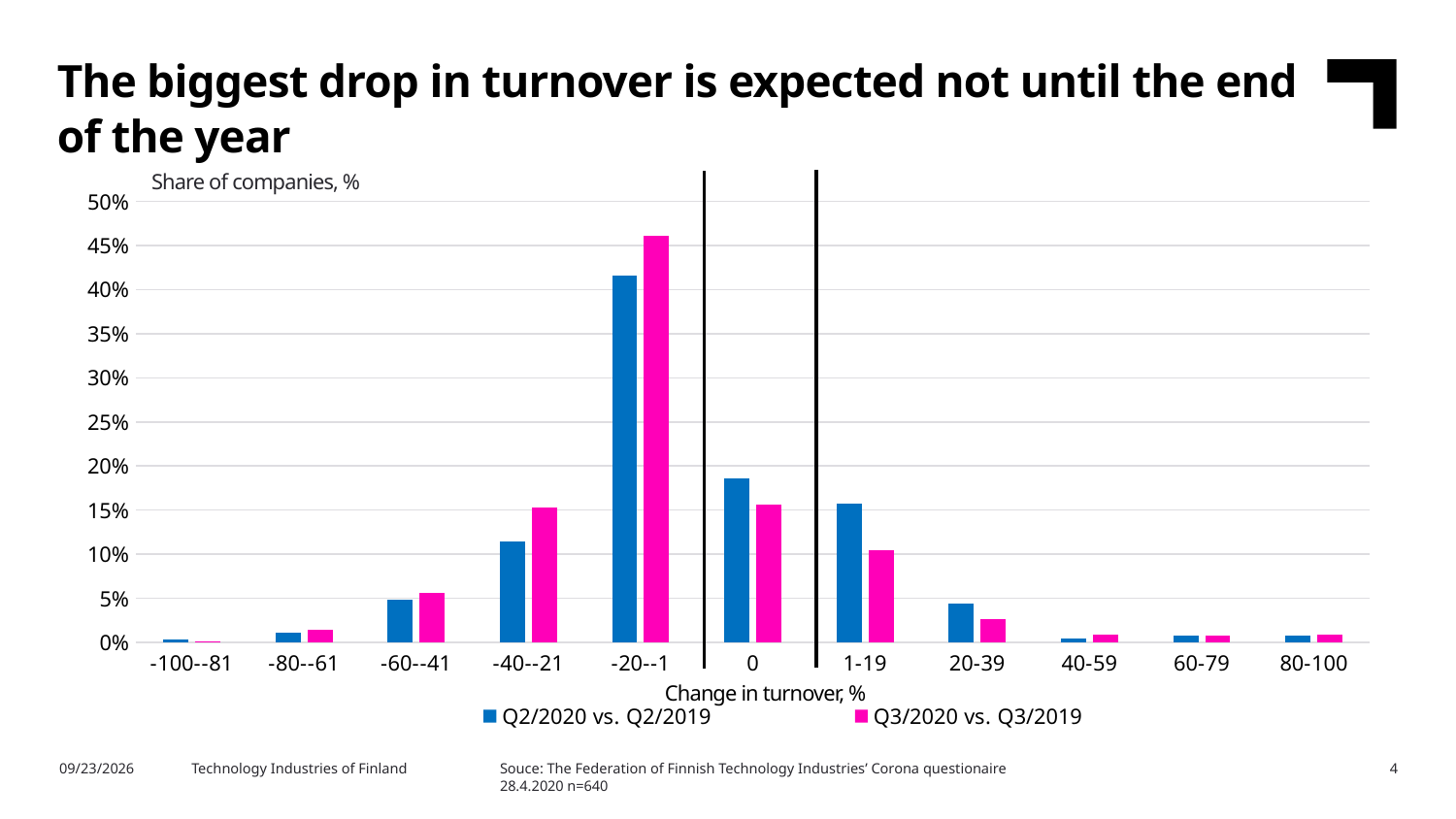
In the 1-19 category, which series has the larger value: Q2/2020 vs. Q2/2019 or Q3/2020 vs. Q3/2019? Q2/2020 vs. Q2/2019 Is the Q2/2020 vs. Q2/2019 value for the 20-39 category greater or less than 5%? less Which category has the highest share of companies for Q3/2020 vs. Q3/2019? -20--1 Which category has the highest share of companies for Q2/2020 vs. Q2/2019? -20--1 How many change-in-turnover categories are shown on the x axis? 11 How many series does the legend list? 2 Is the Q2/2020 vs. Q2/2019 value for the -20--1 category greater or less than 40%? greater In the -40--21 category, which series has the larger value: Q2/2020 vs. Q2/2019 or Q3/2020 vs. Q3/2019? Q3/2020 vs. Q3/2019 What kind of chart is shown on the slide? bar chart Is the Q3/2020 vs. Q3/2019 value for the -40--21 category greater or less than 10%? greater What is the title of the x axis of the chart? Change in turnover, %